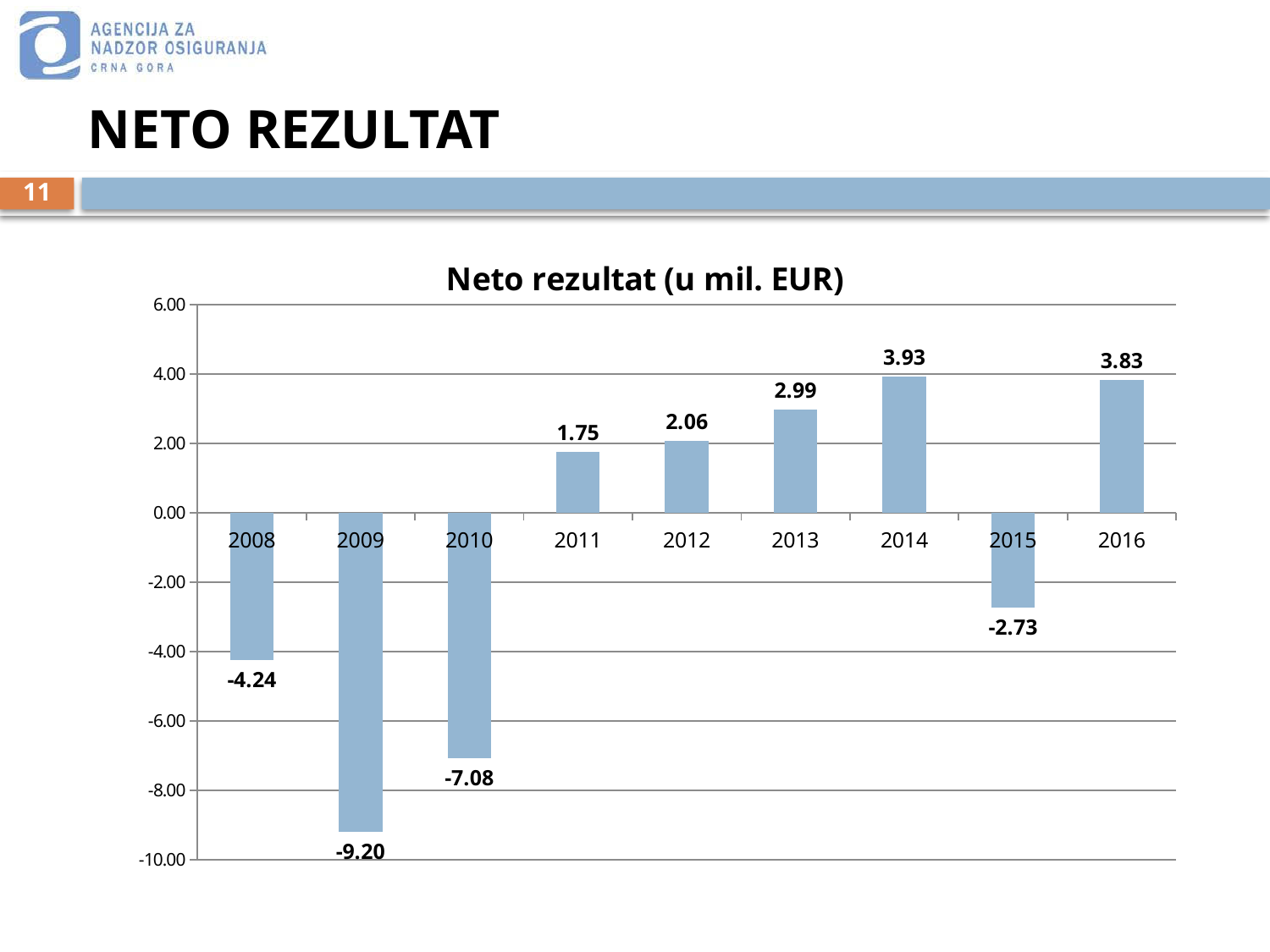
What is the net result for 2015? -2.73 Is the value for 2010 greater or less than -6.00? less What is the title of the chart? Neto rezultat (u mil. EUR) What is the net result for 2014? 3.93 What kind of chart is shown on the slide? bar chart Do the net result values rise or fall from 2011 to 2014? rise What is the difference between the net result in 2016 and in 2011? 2.08 Which year has the highest net result? 2014 Which year has the larger net result, 2012 or 2013? 2013 What is the net result for 2009? -9.20 Which year has the lowest net result? 2009 How many years are shown on the chart? 9